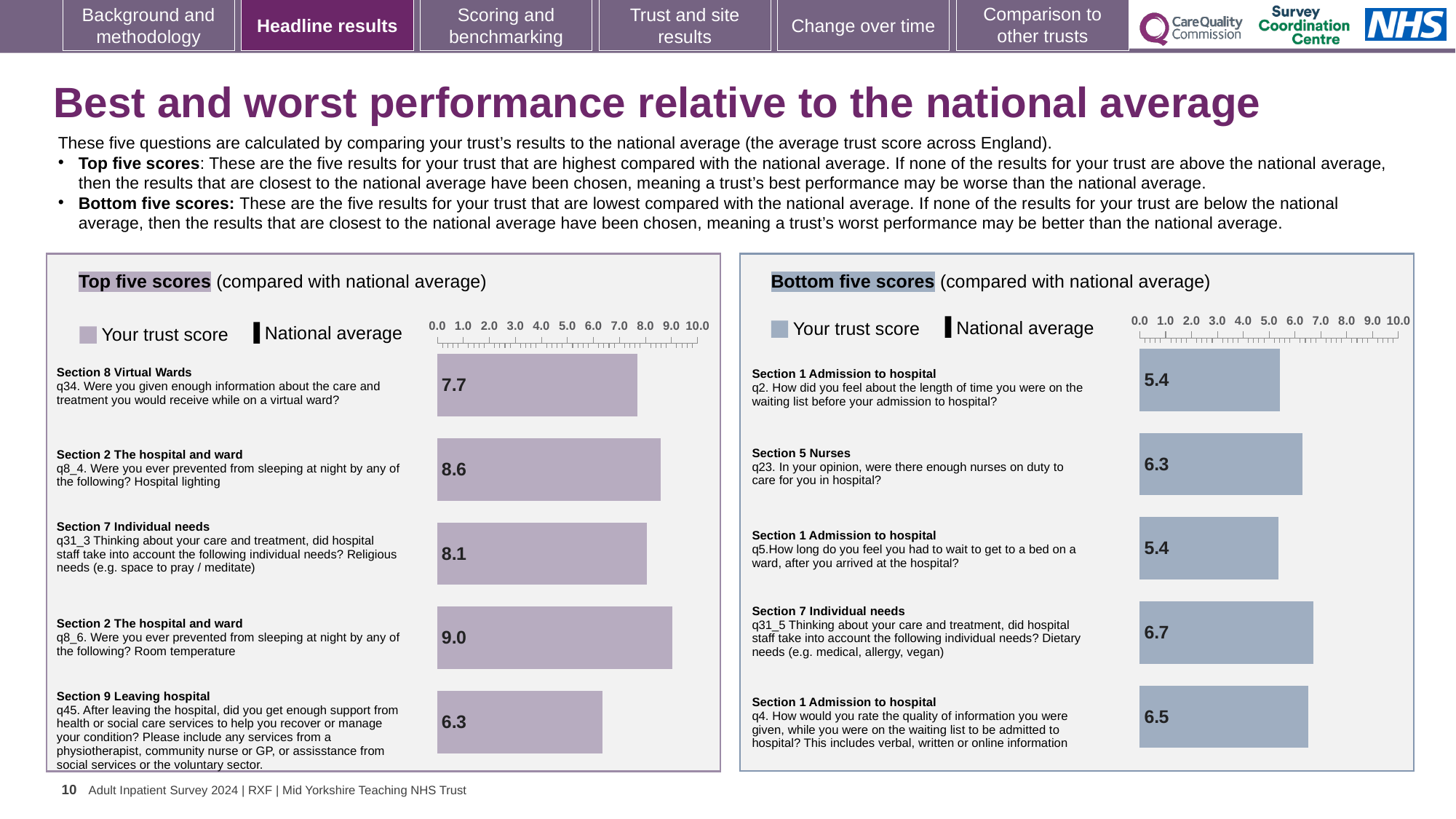
In the Top five scores chart, what is the trust score for q34 (Section 8 Virtual Wards)? 7.7 In the Bottom five scores chart, which is larger, the score for q4 or the score for q2? q4 How many questions are shown in the Top five scores chart? 5 In the Top five scores chart, which question has the highest trust score? q8_6 (Room temperature) In the Top five scores chart, what is the difference between the scores for q8_4 and q45? 2.3 In the Bottom five scores chart, what is the difference between the scores for q31_5 and q5? 1.3 In the Bottom five scores chart, what is the trust score for q31_5 (Dietary needs)? 6.7 What type of chart is used in the Bottom five scores panel? Bar chart In the Bottom five scores chart, which question has the highest trust score? q31_5 (Dietary needs) In the Bottom five scores chart, what is the trust score for q23 (Section 5 Nurses)? 6.3 In the Top five scores chart, what is the trust score for q8_6 (Room temperature)? 9.0 In the Top five scores chart, which question has the lowest trust score? q45 (Leaving hospital)